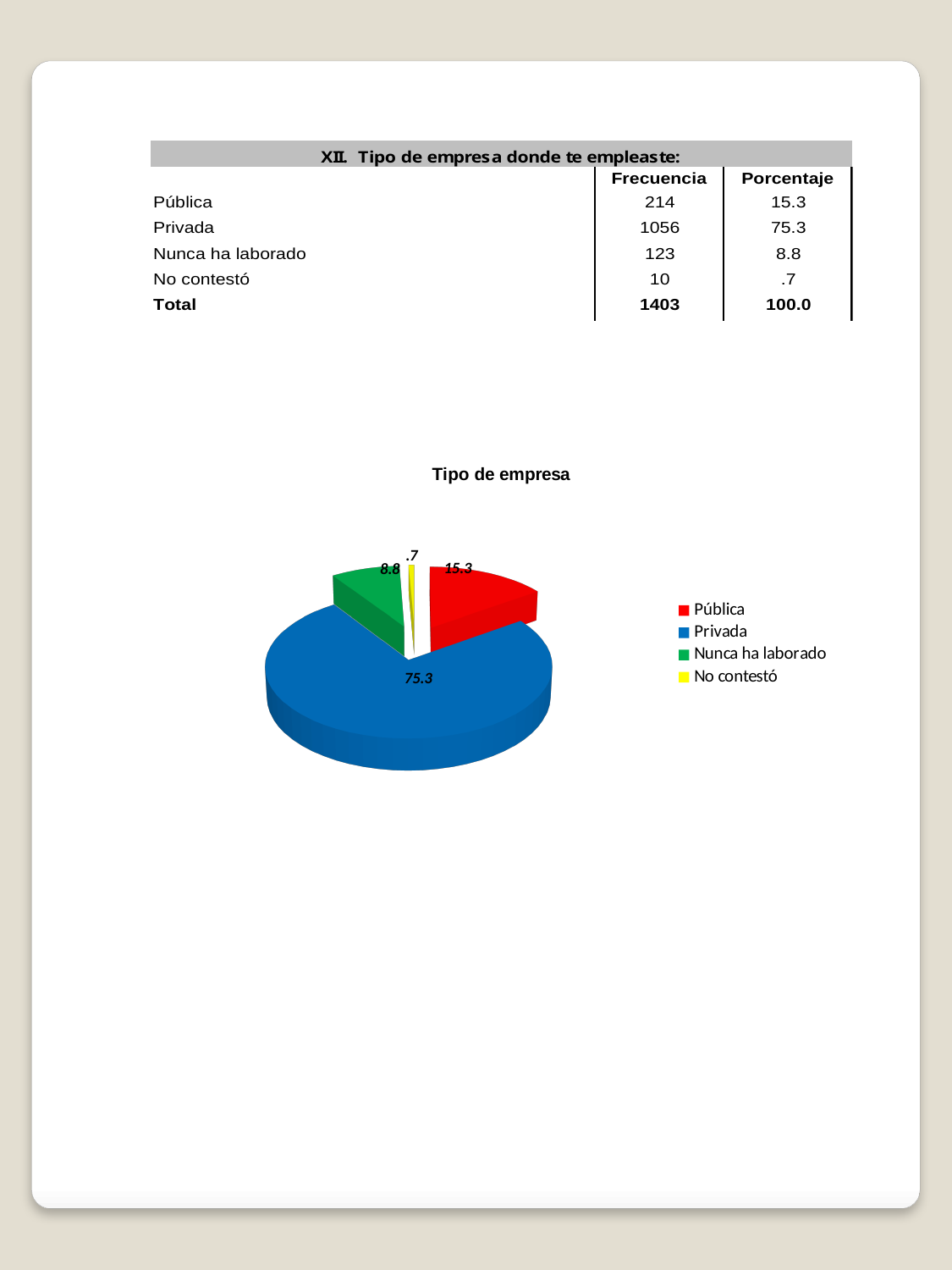
What value is shown for the Privada slice? 75.3 What type of chart is shown on the slide? pie chart What value is shown for the No contestó slice? .7 Which is larger, the Pública slice or the Nunca ha laborado slice? Pública How many categories does the legend list? 4 What colour is the Privada slice? blue Which category has the smallest slice of the pie? No contestó Which category has the largest slice of the pie? Privada What is the title of the chart? Tipo de empresa What value is shown for the Nunca ha laborado slice? 8.8 What is the difference between the Privada and Pública values? 60.0 What value is shown for the Pública slice? 15.3